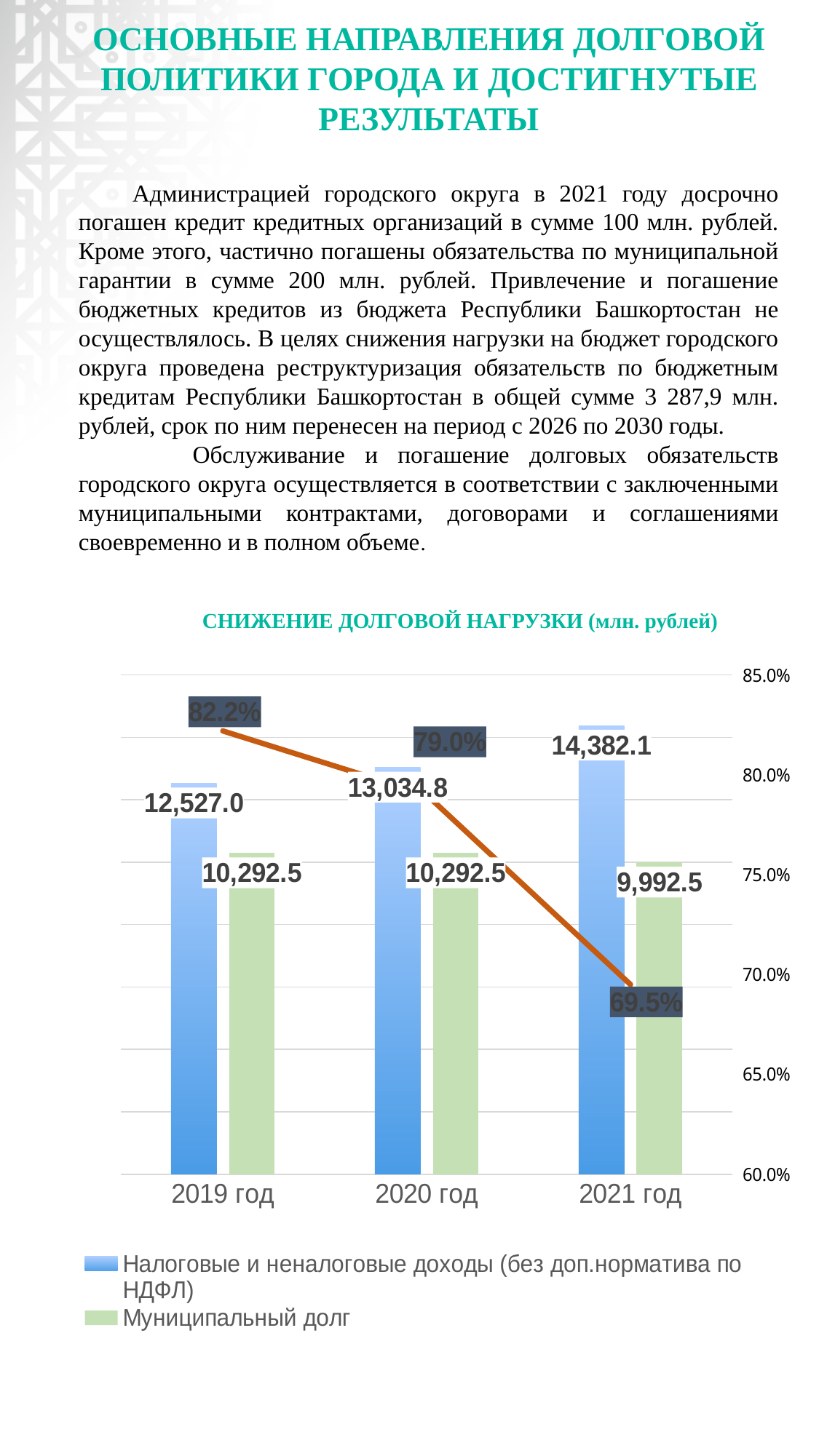
Does the percentage line rise or fall from 2019 год to 2021 год? fall How many years are shown on the x axis of the chart? 3 What is the title of the chart? СНИЖЕНИЕ ДОЛГОВОЙ НАГРУЗКИ (млн. рублей) What is the value of Налоговые и неналоговые доходы (без доп.норматива по НДФЛ) for 2019 год? 12,527.0 What is the difference between Налоговые и неналоговые доходы (без доп.норматива по НДФЛ) and Муниципальный долг in 2021 год? 4,389.6 What percentage is shown on the line for 2020 год? 79.0% What is the value of Муниципальный долг for 2021 год? 9,992.5 In which year is Муниципальный долг the lowest? 2021 год Which is larger in 2020 год: Налоговые и неналоговые доходы (без доп.норматива по НДФЛ) or Муниципальный долг? Налоговые и неналоговые доходы (без доп.норматива по НДФЛ) In which year is Налоговые и неналоговые доходы (без доп.норматива по НДФЛ) the highest? 2021 год What is the value of Налоговые и неналоговые доходы (без доп.норматива по НДФЛ) for 2021 год? 14,382.1 How many series does the legend list? 2